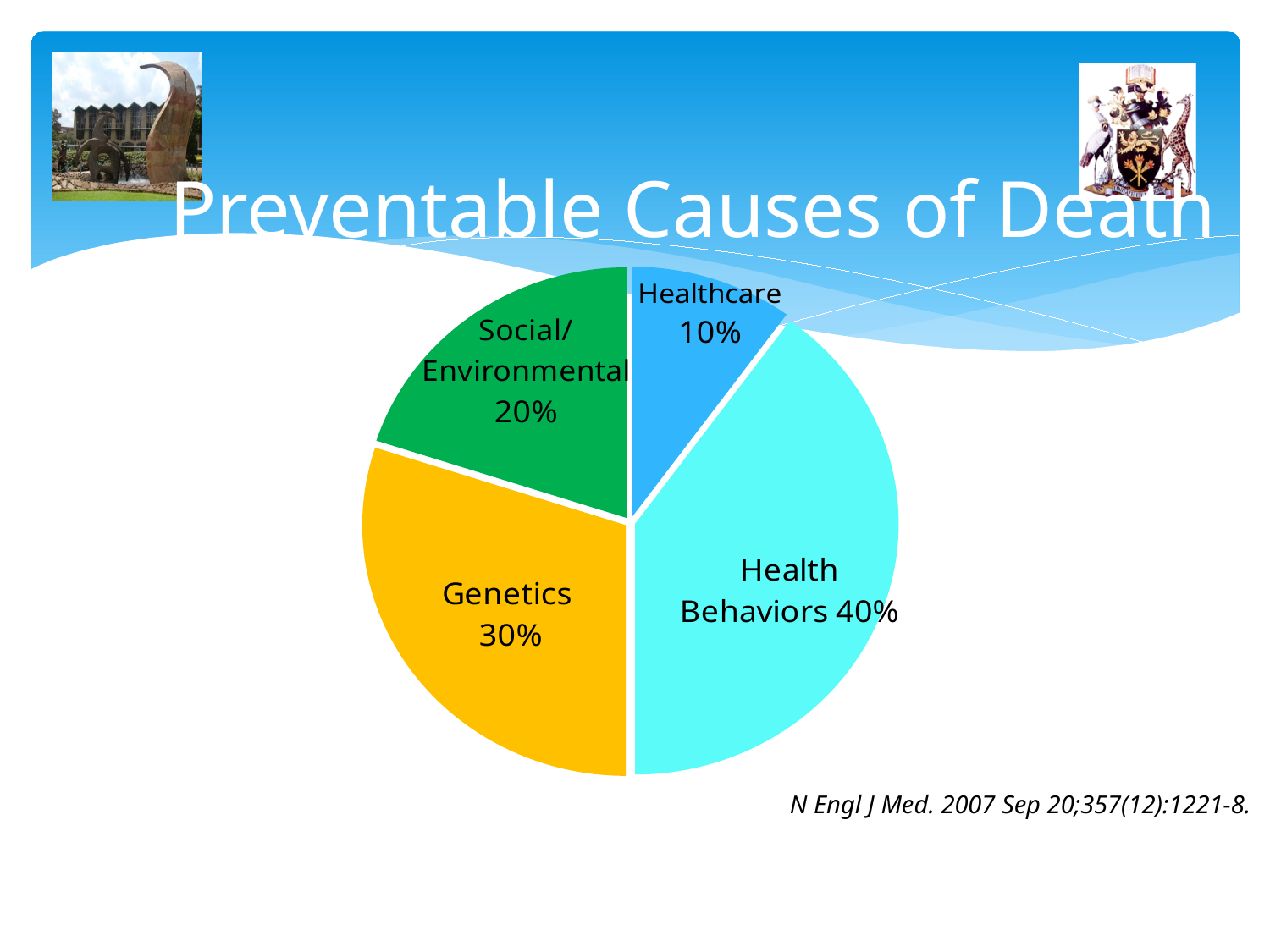
What share of preventable causes of death is attributed to Genetics? 30% What kind of chart is shown on the slide? Pie chart What share of preventable causes of death is attributed to Health Behaviors? 40% What is the difference in percentage points between Health Behaviors and Healthcare? 30 What is the difference in percentage points between Genetics and Social/Environmental? 10 How many categories are shown in the pie chart? 4 What is the title of the slide containing the pie chart? Preventable Causes of Death Which is larger, the Genetics slice or the Social/Environmental slice? Genetics What share of preventable causes of death is attributed to Social/Environmental factors? 20% Which category has the smallest slice of the pie? Healthcare Which category has the largest slice of the pie? Health Behaviors What share of preventable causes of death is attributed to Healthcare? 10%